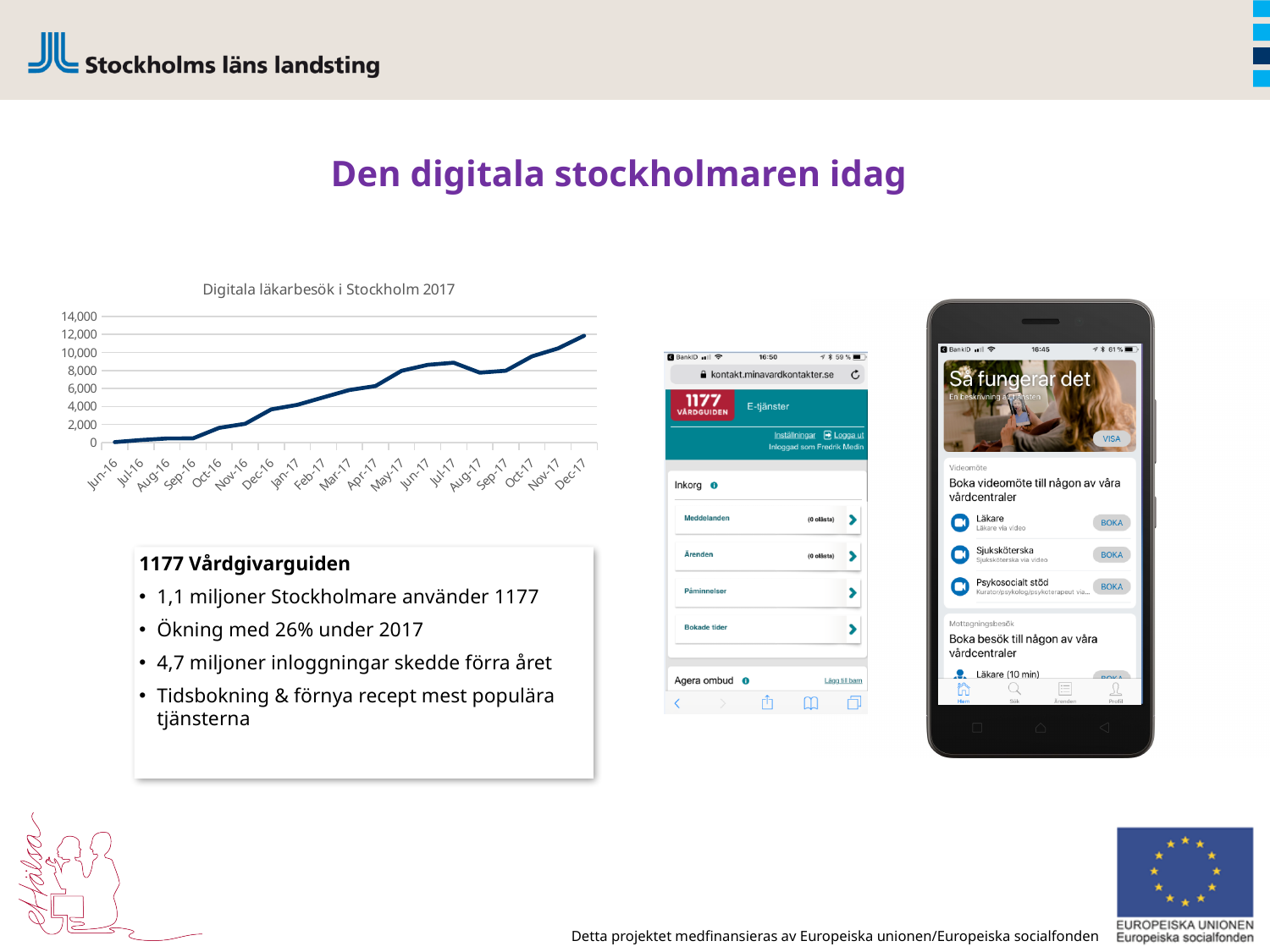
Do the values in the chart generally rise or fall from Jun-16 to Dec-17? Rise Is the value for Jan-17 greater or less than 2,000? greater What is the title of the chart? Digitala läkarbesök i Stockholm 2017 What is the highest tick value shown on the y axis of the chart? 14,000 Is the value for Jun-16 greater or less than 2,000? less Is the value for Dec-17 greater or less than 10,000? greater Which is larger, the value for Nov-17 or the value for Sep-17? Nov-17 How many months are plotted along the x axis of the chart? 19 What kind of chart is shown on the slide? Line chart Which month has the lowest value in the chart? Jun-16 Which month has the highest value in the chart? Dec-17